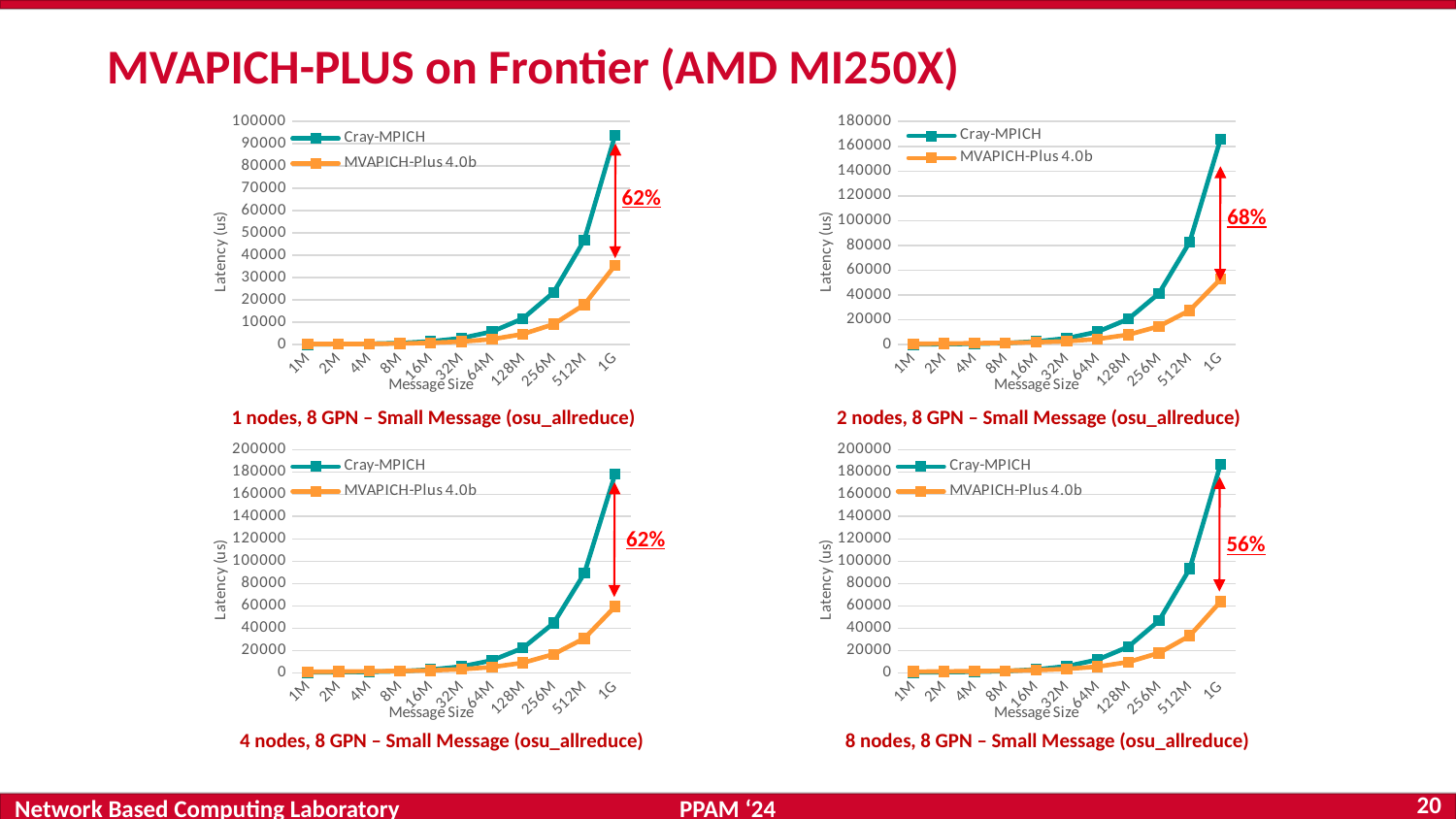
In the '2 nodes, 8 GPN – Small Message (osu_allreduce)' chart, is the Cray-MPICH latency at 1G greater or less than 140000? greater In the '4 nodes, 8 GPN – Small Message (osu_allreduce)' chart, is the MVAPICH-Plus 4.0b latency at 1G greater or less than 80000? less In the '2 nodes, 8 GPN – Small Message (osu_allreduce)' chart, does the Cray-MPICH latency rise or fall as message size increases from 1M to 1G? rise What kind of chart is the '1 nodes, 8 GPN – Small Message (osu_allreduce)' chart? line chart In the '1 nodes, 8 GPN – Small Message (osu_allreduce)' chart, is the Cray-MPICH latency at 1G greater or less than 80000? greater In the '8 nodes, 8 GPN – Small Message (osu_allreduce)' chart, which series has the higher latency at 1G, Cray-MPICH or MVAPICH-Plus 4.0b? Cray-MPICH What percentage improvement is annotated on the '8 nodes, 8 GPN – Small Message (osu_allreduce)' chart? 56% How many series does the legend list in the '2 nodes, 8 GPN – Small Message (osu_allreduce)' chart? 2 What percentage improvement is annotated on the '2 nodes, 8 GPN – Small Message (osu_allreduce)' chart? 68% How many message sizes are plotted along the x axis of the '4 nodes, 8 GPN – Small Message (osu_allreduce)' chart? 11